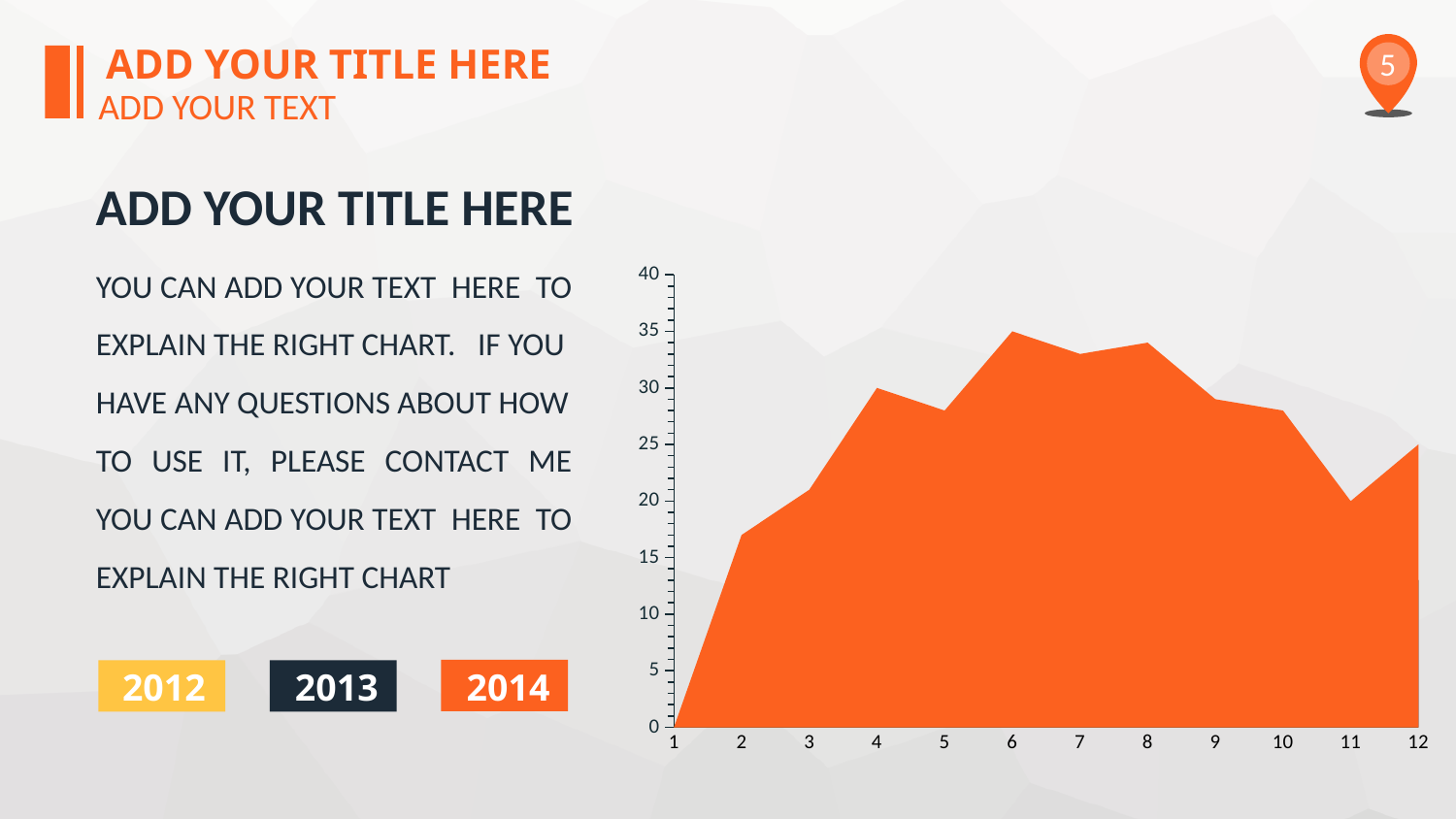
Is the value at point 6 greater or less than 30? greater How many points are plotted along the x axis of the chart? 12 Is the value at point 11 greater or less than 25? less Which has the larger value, point 6 or point 11? 6 Do the values rise or fall from point 1 to point 6? rise Which has the larger value, point 4 or point 2? 4 Is the value at point 2 greater or less than 20? less What kind of chart is shown on the slide? area chart Which x-axis point has the lowest value in the chart? 1 Do the values rise or fall from point 8 to point 11? fall